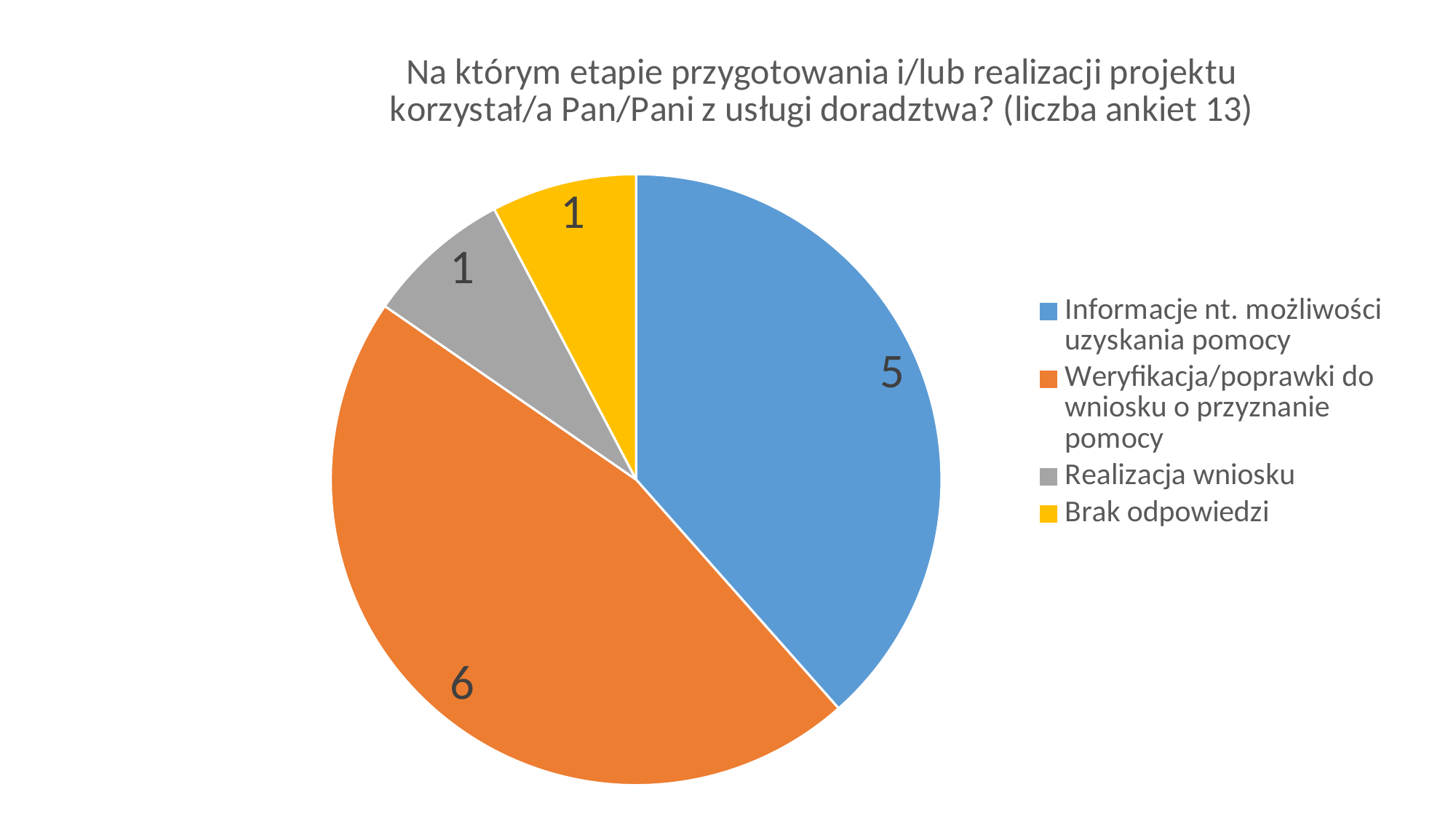
What is the value for 'Brak odpowiedzi'? 1 Which is larger: the value for 'Informacje nt. możliwości uzyskania pomocy' or for 'Realizacja wniosku'? Informacje nt. możliwości uzyskania pomocy Which category has the largest slice of the pie? Weryfikacja/poprawki do wniosku o przyznanie pomocy What is the value for 'Weryfikacja/poprawki do wniosku o przyznanie pomocy'? 6 What is the value for 'Realizacja wniosku'? 1 What is the difference between the values for 'Weryfikacja/poprawki do wniosku o przyznanie pomocy' and 'Informacje nt. możliwości uzyskania pomocy'? 1 What is the total of all slice values in the pie chart? 13 What type of chart is shown on the slide? pie chart What is the value for 'Informacje nt. możliwości uzyskania pomocy'? 5 What colour is the slice for 'Brak odpowiedzi'? yellow Which categories share the smallest value in the pie chart? Realizacja wniosku and Brak odpowiedzi How many slices does the pie chart have? 4